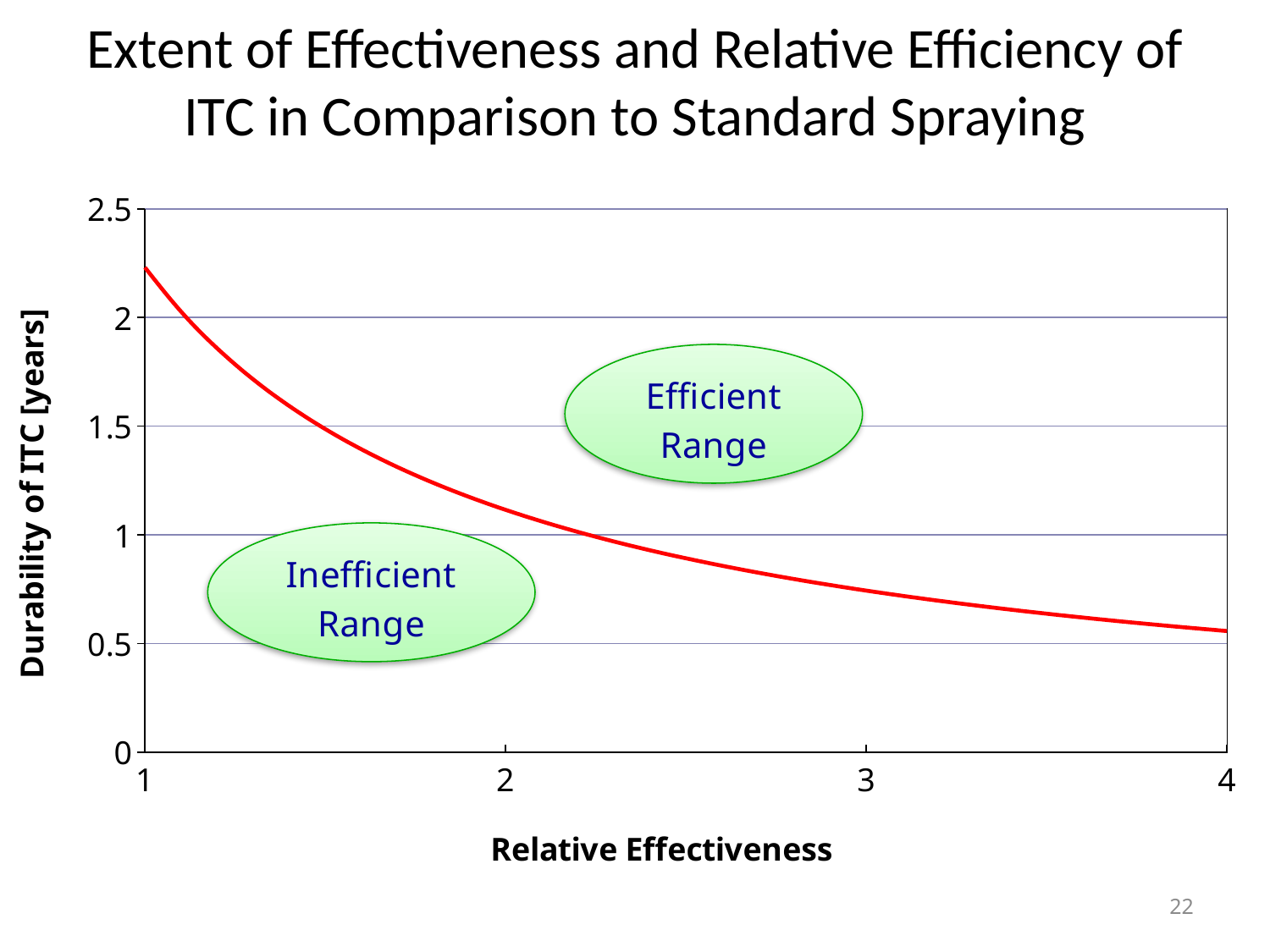
Is the Durability of ITC at a Relative Effectiveness of 2 greater or less than 1.5 years? less Is the Durability of ITC at a Relative Effectiveness of 4 greater or less than 1 year? less Which labelled range lies above the red curve? Efficient Range Is the Durability of ITC at a Relative Effectiveness of 3 greater or less than 1 year? less Does the red curve rise or fall as Relative Effectiveness increases from 1 to 4? fall What is the title of the y axis? Durability of ITC [years] At which Relative Effectiveness value shown on the x axis is the Durability of ITC lowest? 4 Which is larger, the Durability of ITC at a Relative Effectiveness of 2 or at 3? 2 At which Relative Effectiveness value shown on the x axis is the Durability of ITC highest? 1 What kind of chart is shown on the slide? line chart